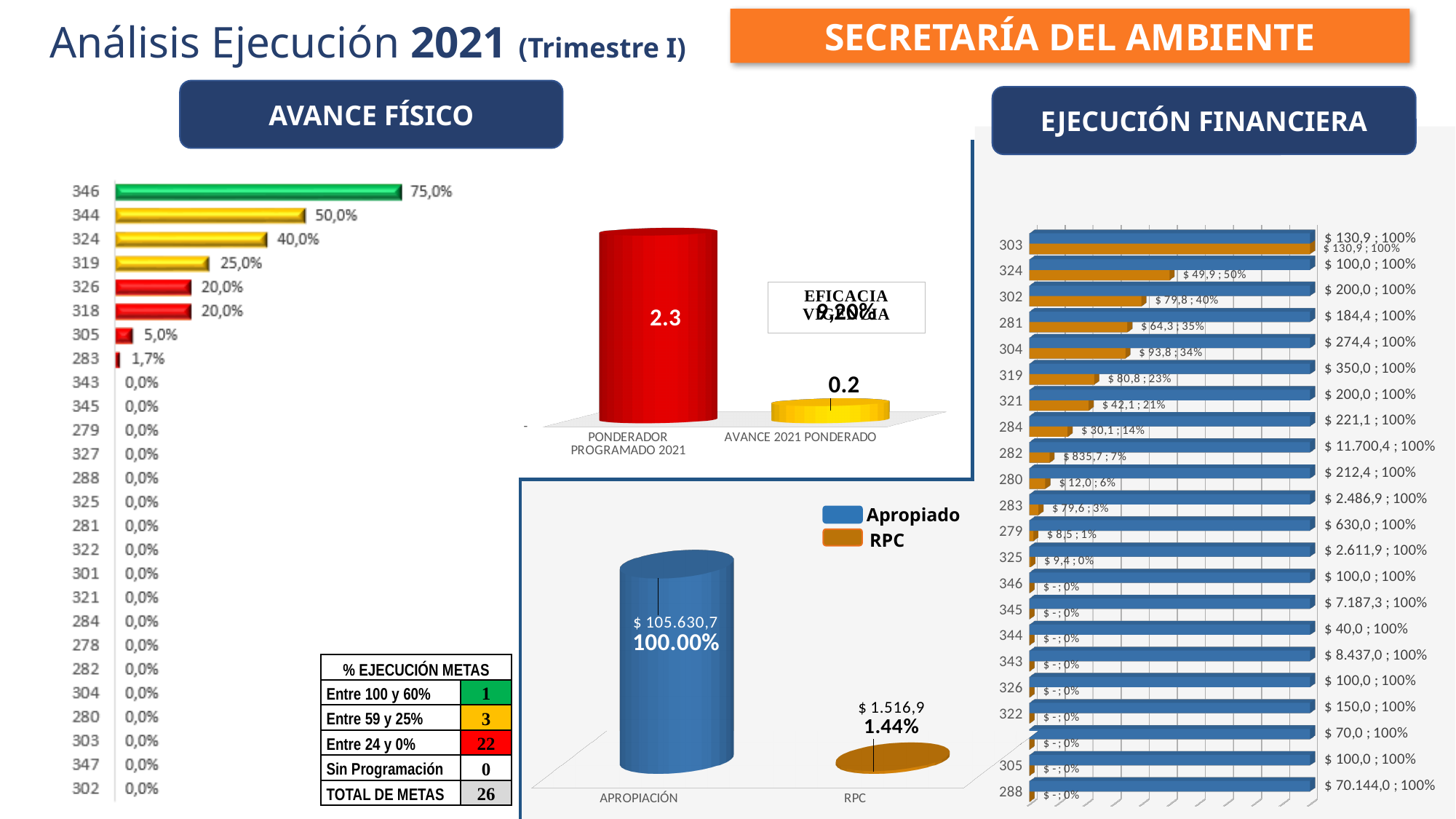
In the AVANCE FÍSICO bar chart on the left, what is the value for category 346? 75,0% In the chart with PONDERADOR PROGRAMADO 2021 and AVANCE 2021 PONDERADO, which of the two values is larger? PONDERADOR PROGRAMADO 2021 In the AVANCE FÍSICO bar chart on the left, how many categories are plotted? 26 In the AVANCE FÍSICO bar chart on the left, what is the difference between the values for 344 and 319? 25,0% In the chart with PONDERADOR PROGRAMADO 2021 and AVANCE 2021 PONDERADO, what is the value for PONDERADOR PROGRAMADO 2021? 2.3 In the AVANCE FÍSICO bar chart on the left, which category has the highest value? 346 In the EJECUCIÓN FINANCIERA bar chart on the right, what is the Apropiado label for category 282? $ 11.700,4 ; 100% In the AVANCE FÍSICO bar chart on the left, what is the value for category 324? 40,0% In the EJECUCIÓN FINANCIERA bar chart on the right, what is the RPC label for category 324? $ 49,9 ; 50% In the bottom-middle chart with APROPIACIÓN and RPC, what percentage is shown for APROPIACIÓN? 100.00% In the bottom-middle chart with APROPIACIÓN and RPC, how many series does the legend list? 2 In the bottom-middle chart with APROPIACIÓN and RPC, what dollar value is shown for RPC? $ 1.516,9